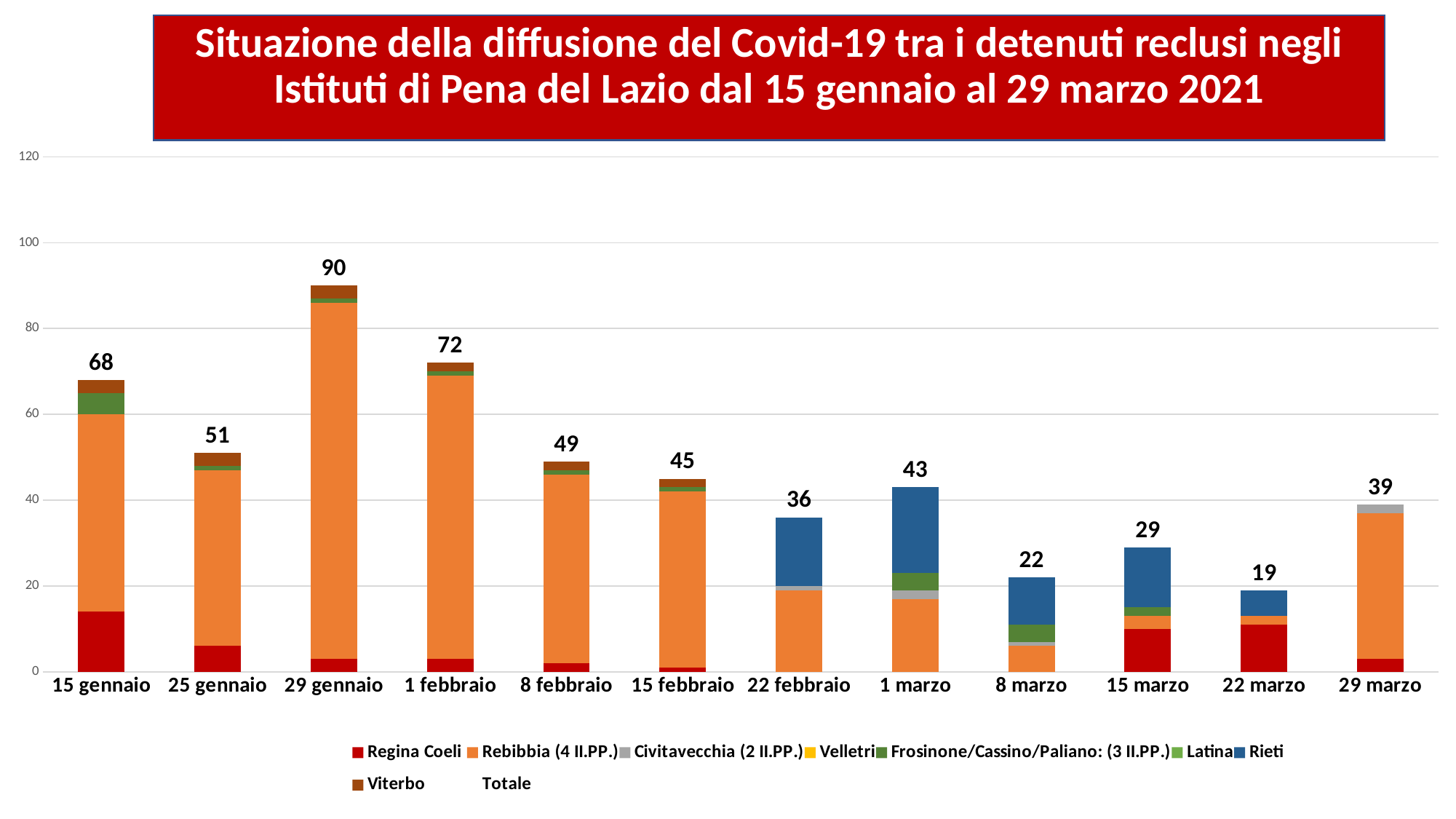
Is the Regina Coeli value for 15 gennaio greater or less than 20? less What kind of chart is shown on the slide? stacked bar chart Which legend entry is shown in blue? Rieti What is the difference between the totals for 29 gennaio and 15 gennaio? 22 Which date has the highest total? 29 gennaio How many dates are shown on the x axis? 12 Do the totals rise or fall from 29 gennaio to 22 marzo? fall Which date has the lowest total? 22 marzo How many entries does the legend list? 9 What is the total value shown for 22 febbraio? 36 Which has a larger total, 1 marzo or 29 marzo? 1 marzo What is the total value shown for 29 gennaio? 90